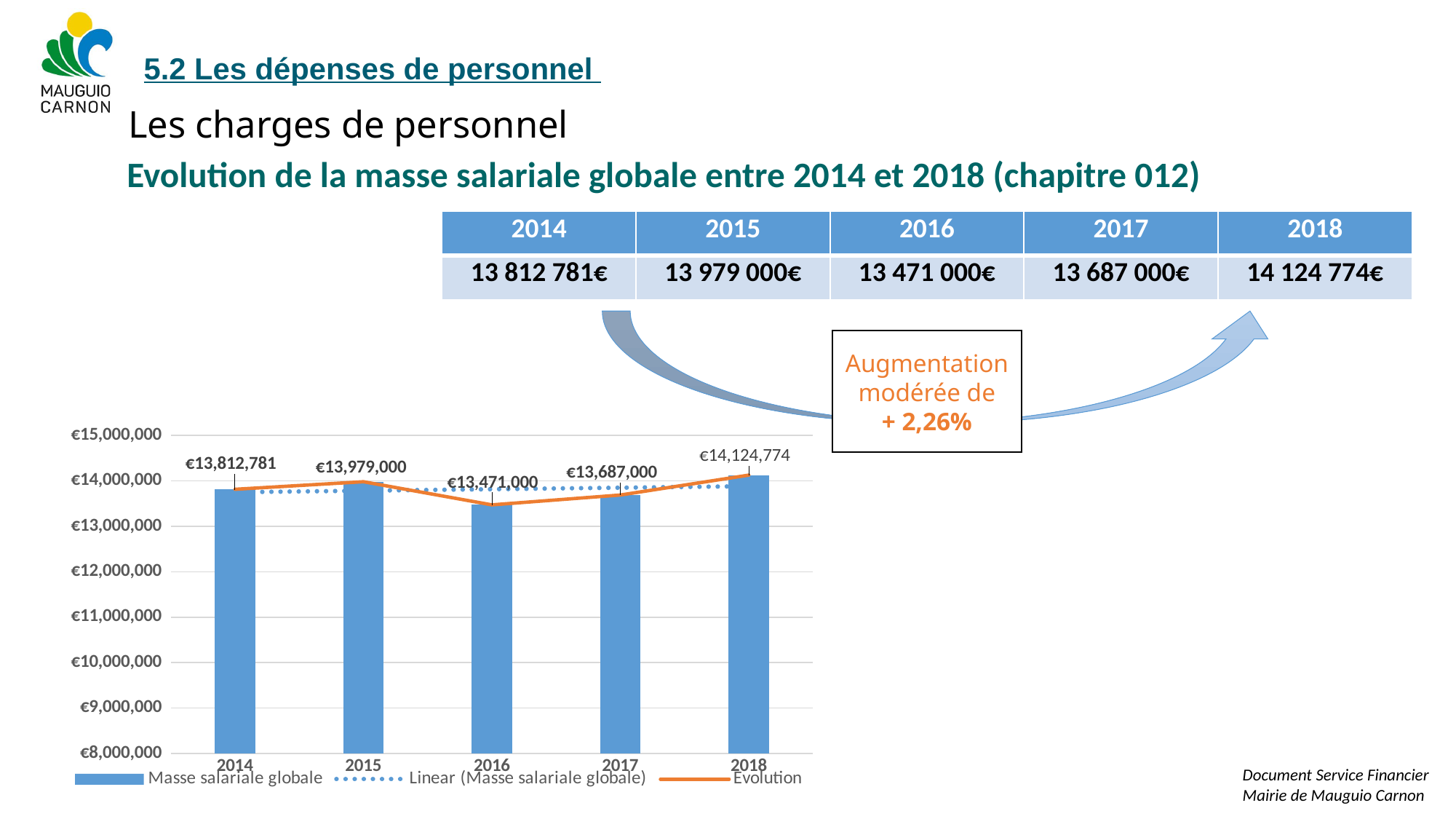
What is the value of Masse salariale globale for 2016? €13,471,000 How many years are shown on the x axis of the chart? 5 Which year has the lowest Masse salariale globale? 2016 What is the difference between the Masse salariale globale in 2018 and in 2014? €311,993 How many series does the chart legend list? 3 What is the value of Masse salariale globale for 2014? €13,812,781 Which year has the highest Masse salariale globale? 2018 What is the value of Masse salariale globale for 2018? €14,124,774 Is the value for 2017 greater or less than €14,000,000? less Which is larger, the Masse salariale globale in 2015 or in 2017? 2015 What kind of chart is used to show the Masse salariale globale? bar chart What is the difference between the Masse salariale globale in 2015 and in 2016? €508,000